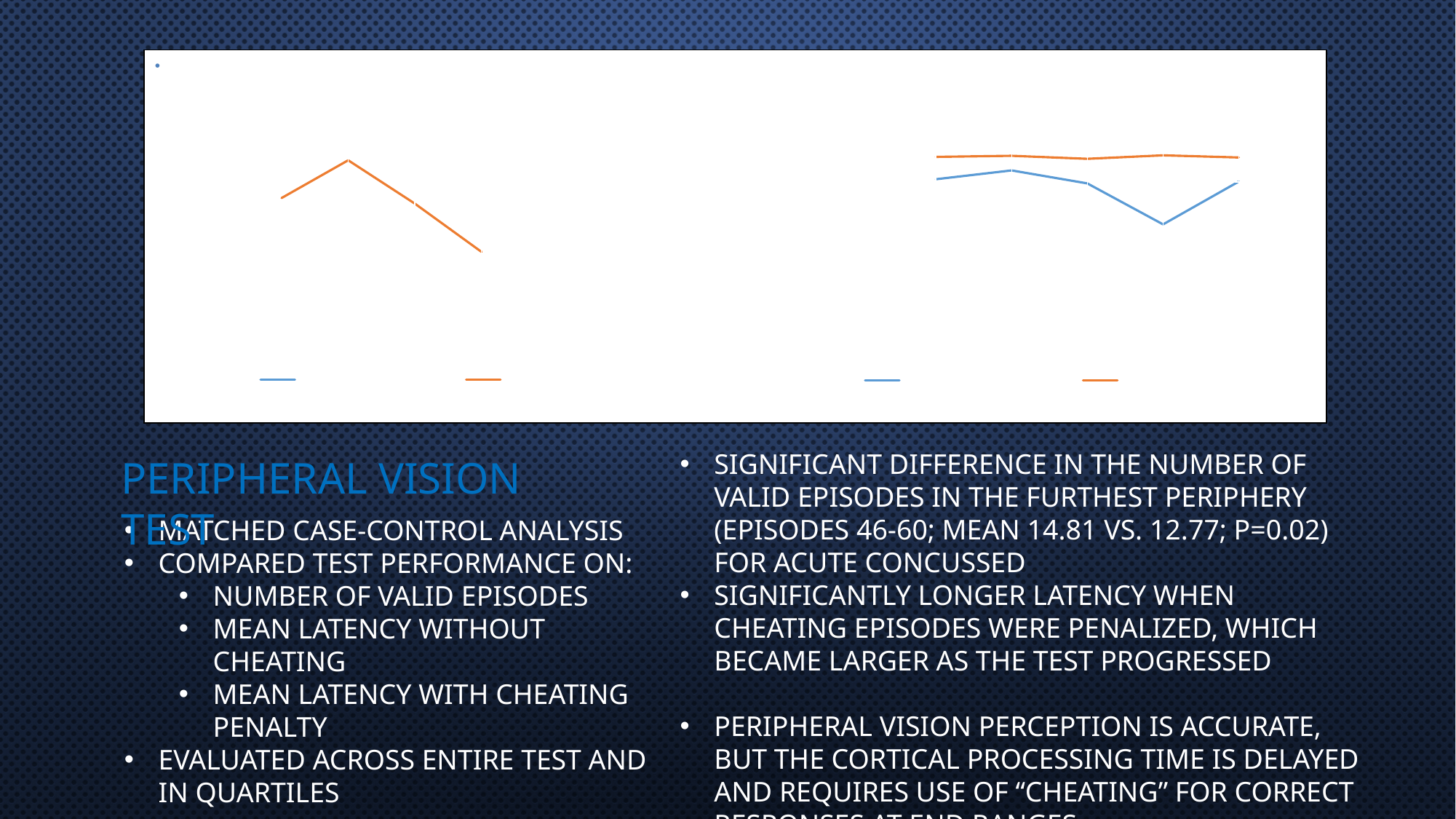
In the left chart, does the orange line rise or fall between its first and second points? rise How many series does the legend of the right chart list? 2 How many data points are plotted on the orange line in the left chart? 4 What kind of chart is the chart on the right side of the slide? line chart In the right chart, which line is plotted higher across the whole x axis, the blue line or the orange line? the orange line How many data points are plotted on each line in the right chart? 5 How many charts are shown on the slide? 2 What kind of chart is the chart on the left side of the slide? line chart In the left chart, does the orange line rise or fall between its second and third points? fall How many series does the legend of the left chart list? 2